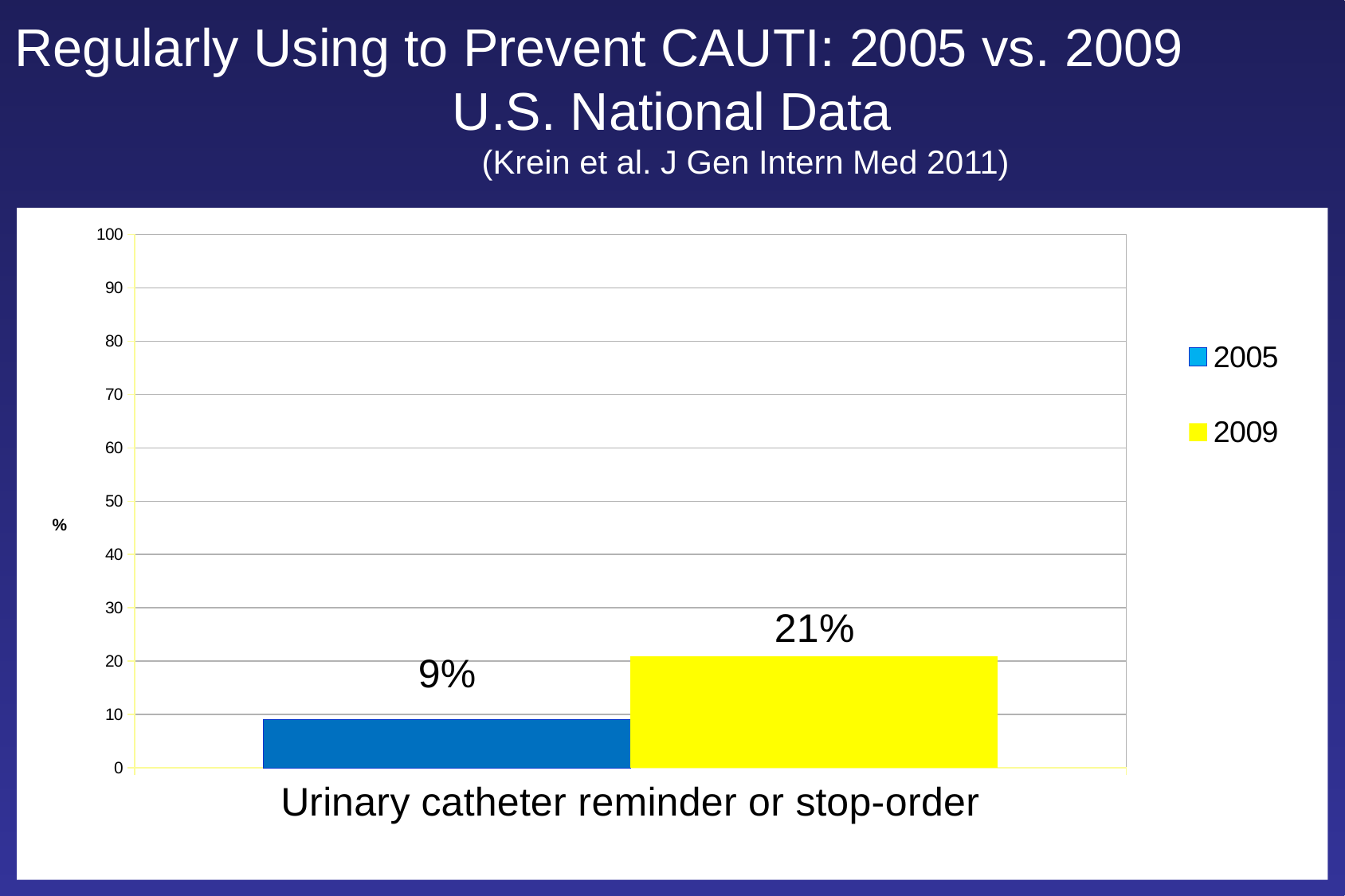
What colour is the bar for 2009? yellow What is the value for 2009 for Urinary catheter reminder or stop-order? 21% What is the label of the category on the x axis? Urinary catheter reminder or stop-order Which series has the lowest value on the chart? 2005 How many categories are shown on the x axis? 1 How many series does the legend list? 2 Is the value for 2009 greater or less than 30? less What kind of chart is shown on the slide? bar chart What is the value for 2005 for Urinary catheter reminder or stop-order? 9% What is the difference between the 2009 and 2005 values for Urinary catheter reminder or stop-order? 12% Is the value for 2005 greater or less than 10? less Which year has the higher value for Urinary catheter reminder or stop-order, 2005 or 2009? 2009